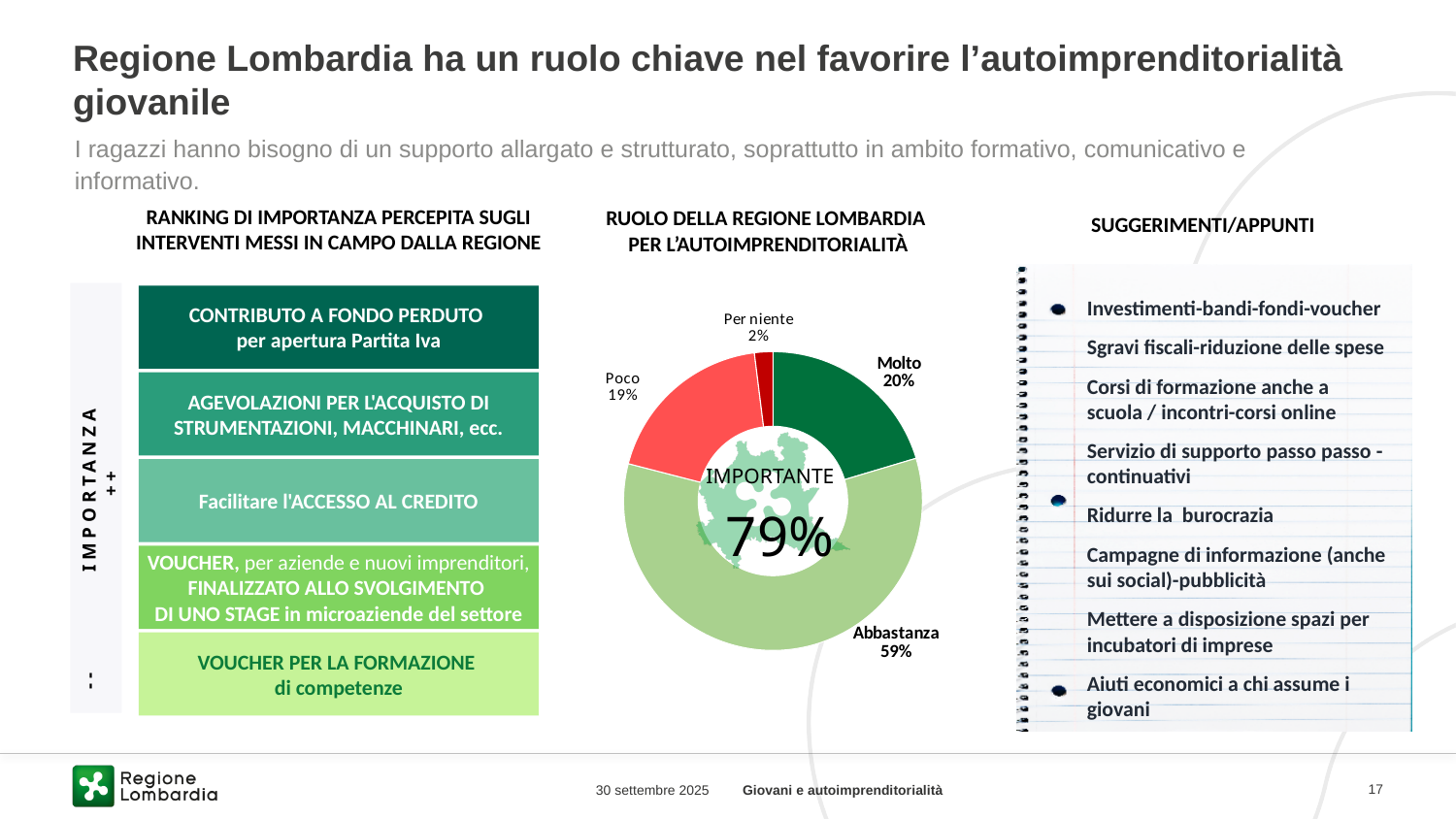
Which slice of the pie chart is the smallest? Per niente What is the combined percentage of 'Molto' and 'Abbastanza' in the pie chart? 79% In the pie chart, which is larger: 'Molto' or 'Poco'? Molto In the pie chart, what percentage is shown for 'Abbastanza'? 59% What kind of chart is shown under the heading 'RUOLO DELLA REGIONE LOMBARDIA PER L'AUTOIMPRENDITORIALITÀ'? Pie chart (donut) What label and value are printed in the centre of the pie chart? IMPORTANTE 79% In the pie chart, what percentage is shown for 'Poco'? 19% In the pie chart, what percentage is shown for 'Molto'? 20% Which slice of the pie chart is the largest? Abbastanza How many slices does the pie chart have? 4 In the pie chart, what percentage is shown for 'Per niente'? 2% What is the difference in percentage points between 'Abbastanza' and 'Molto' in the pie chart? 39